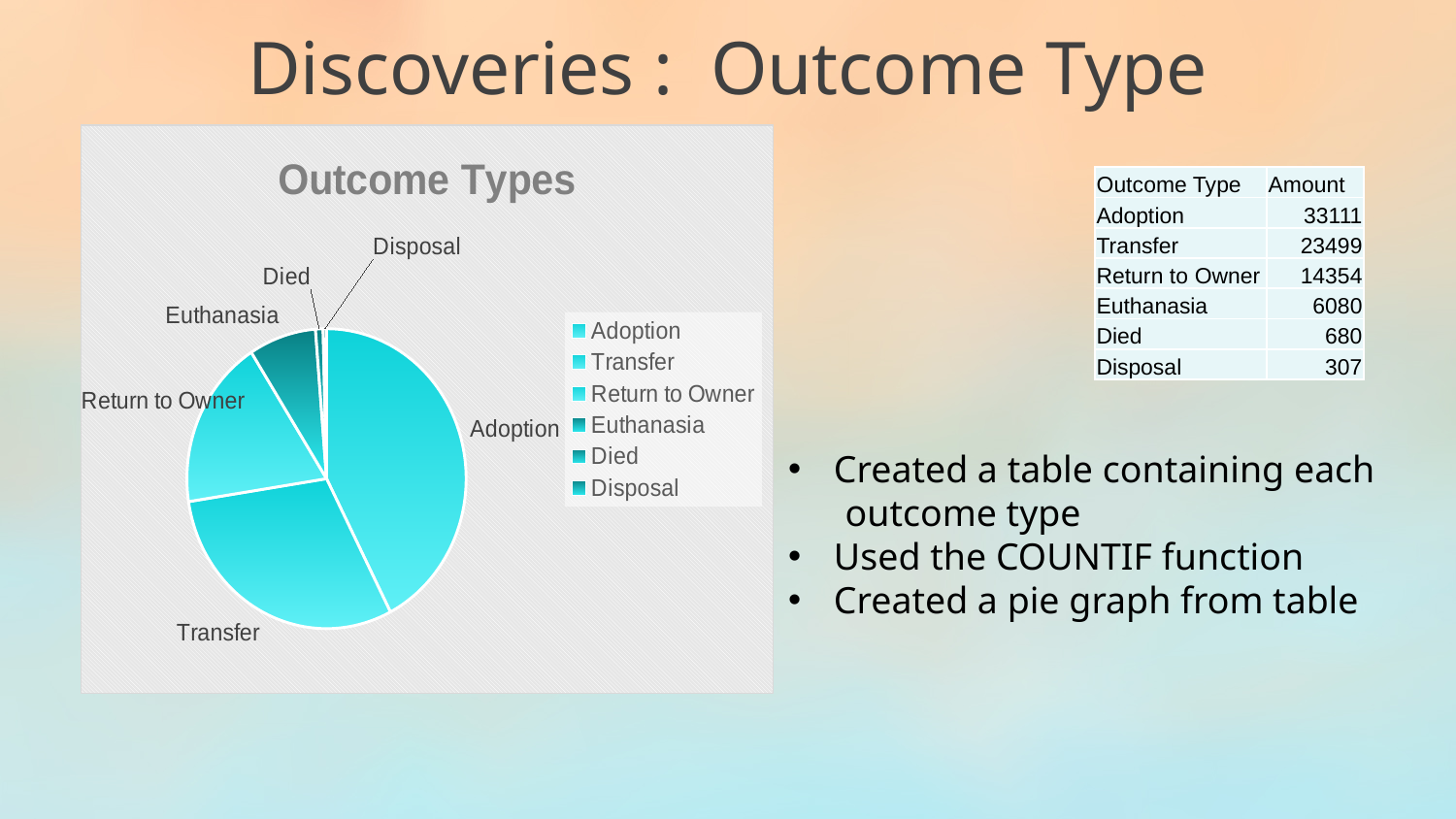
What is the amount for Return to Owner in the Outcome Types pie chart? 14354 What is the amount for Transfer in the Outcome Types pie chart? 23499 What is the difference between the Euthanasia and Died amounts in the Outcome Types chart? 5400 What is the amount for Euthanasia in the Outcome Types pie chart? 6080 What is the amount for Adoption in the Outcome Types pie chart? 33111 What is the amount for Disposal in the Outcome Types pie chart? 307 Which outcome type has the smallest slice in the Outcome Types pie chart? Disposal Which outcome type has the largest slice in the Outcome Types pie chart? Adoption How many outcome types are shown in the Outcome Types pie chart? 6 In the Outcome Types chart, which is larger: Transfer or Return to Owner? Transfer What kind of chart is used to show the Outcome Types? Pie chart What is the difference between the Adoption and Transfer amounts in the Outcome Types chart? 9612